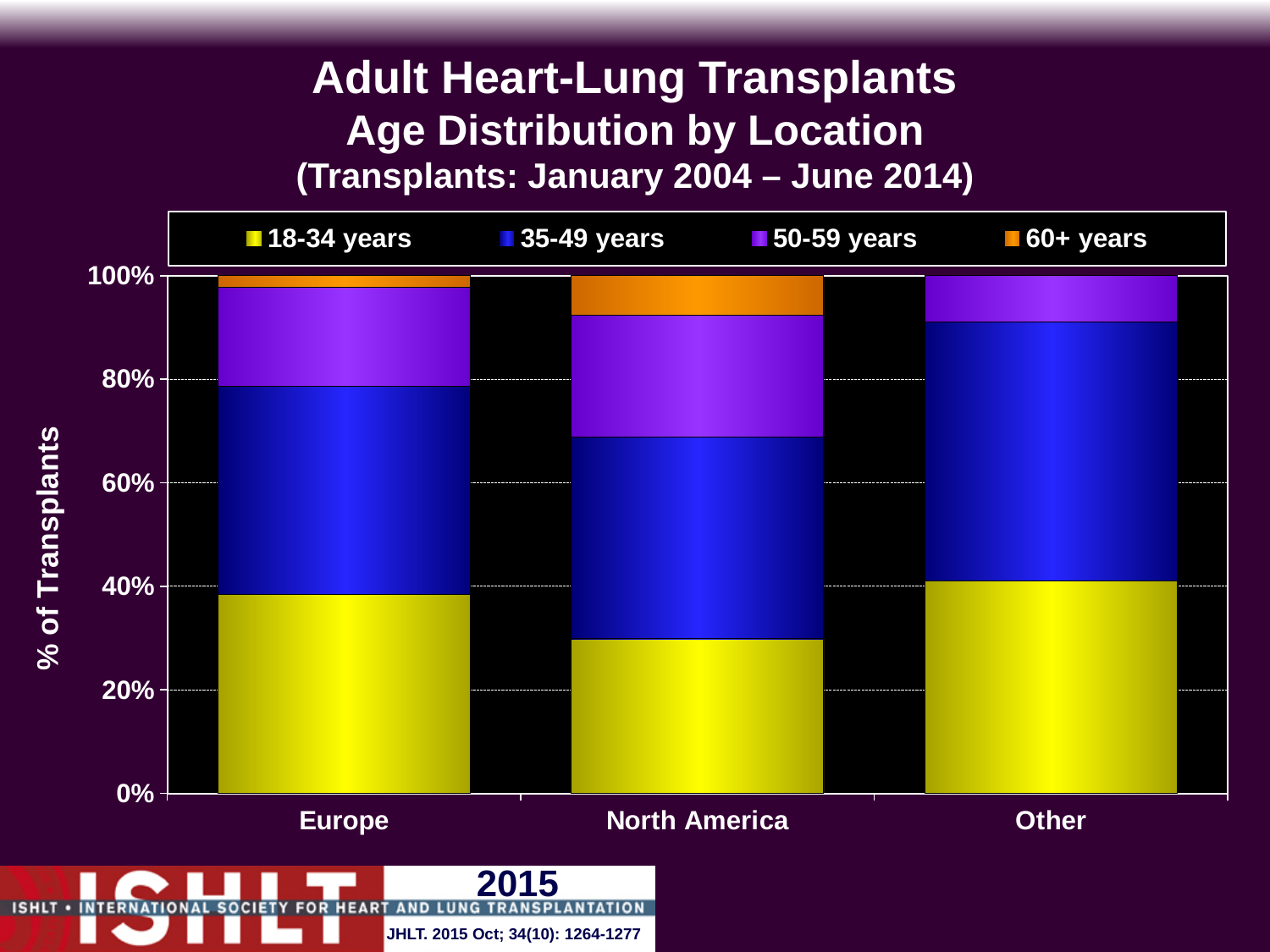
Is the 18-34 years share for North America greater or less than 40%? less Which age group is shown in yellow in the legend? 18-34 years Which location has the smallest 50-59 years share? Other Is the 18-34 years share for Europe greater or less than 20%? greater What is the total height of the stacked bar for Europe? 100% Is the 18-34 years share larger for Europe or for North America? Europe What is the title of the chart? Adult Heart-Lung Transplants Age Distribution by Location (Transplants: January 2004 – June 2014) Which location has the smallest 18-34 years share? North America Which location has the largest 60+ years share? North America What kind of chart is shown on the slide? Stacked bar chart How many age groups does the legend list? 4 How many locations are shown on the x axis of the chart? 3